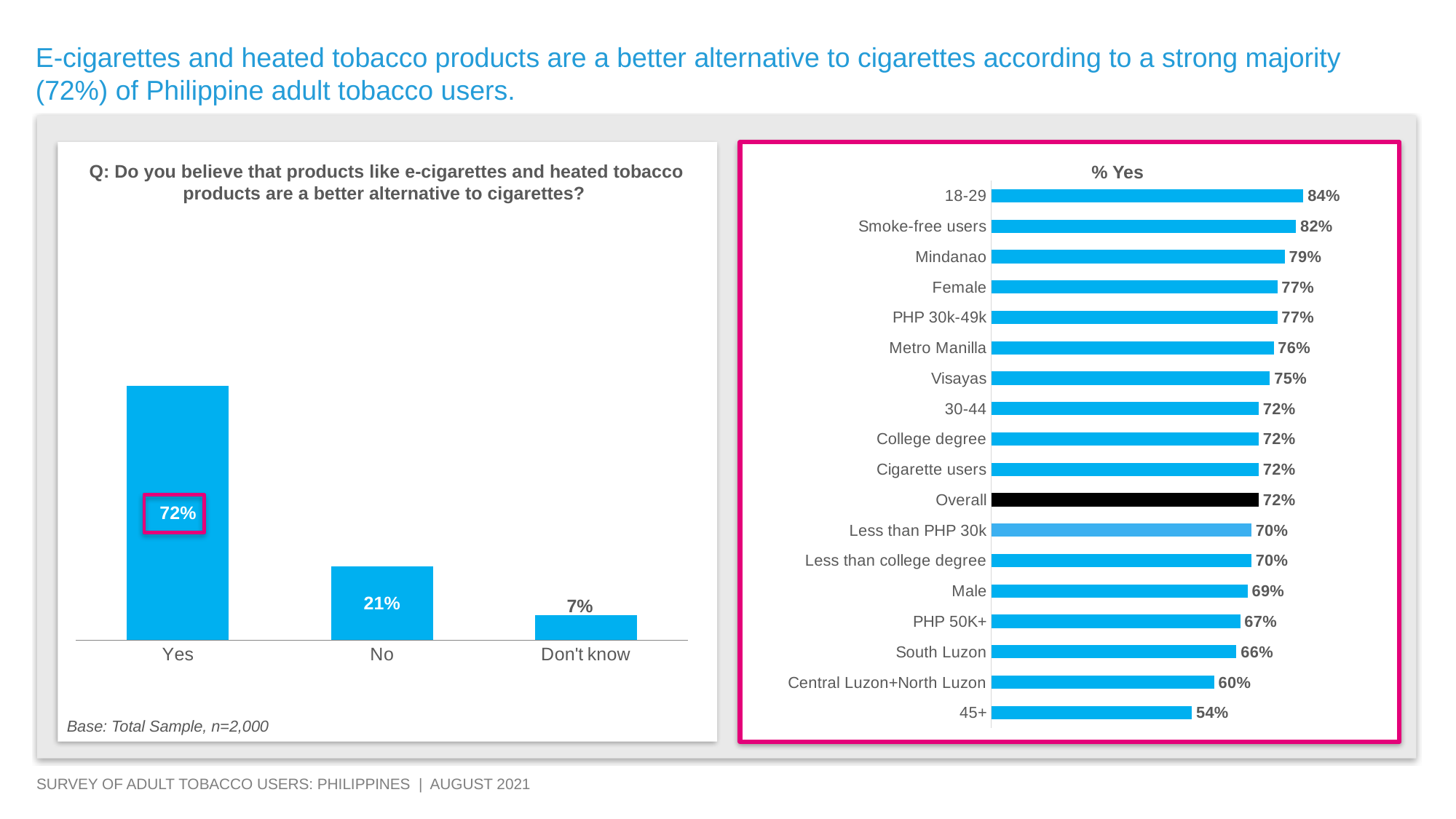
In the '% Yes' chart, which is larger: Female or Male? Female In the '% Yes' chart, what is the difference between Smoke-free users and Cigarette users? 10 percentage points How many categories are shown in the '% Yes' chart? 18 What kind of chart is the left chart? Bar chart How many categories are shown in the left chart? 3 In the '% Yes' chart, which category has the highest value? 18-29 In the left chart, what is the difference between the 'Yes' and 'No' percentages? 51 percentage points In the '% Yes' chart, what is the value for Central Luzon+North Luzon? 60% In the '% Yes' chart, what is the value for Mindanao? 79% In the left chart, what percentage of respondents answered 'Yes'? 72% In the '% Yes' chart, which category has the lowest value? 45+ In the left chart, what percentage of respondents answered 'Don't know'? 7%